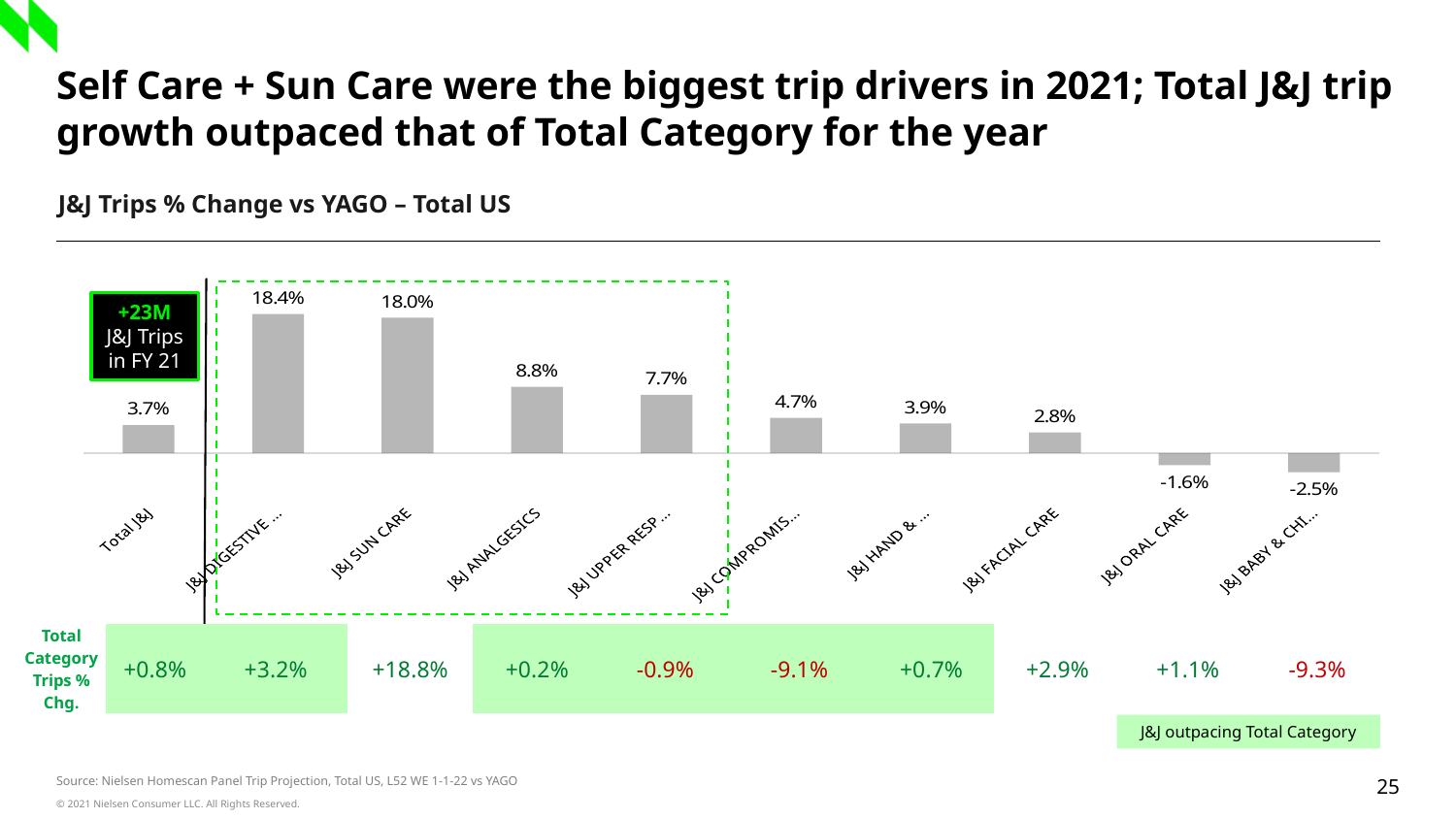
What is the J&J trips % change for J&J Oral Care? -1.6% What is the J&J trips % change for Total J&J? 3.7% What kind of chart is shown on the slide? Bar chart What is the title of the chart? J&J Trips % Change vs YAGO – Total US How many categories are plotted in the bar chart? 10 What is the J&J trips % change for J&J Sun Care? 18.0% Which has a larger J&J trips % change, Total J&J or J&J Facial Care? Total J&J What is the J&J trips % change for J&J Analgesics? 8.8% Which category has the lowest J&J trips % change? J&J Baby & Chi... What is the J&J trips % change for J&J Facial Care? 2.8% What is the difference between the J&J trips % change for J&J Sun Care and J&J Analgesics? 9.2 percentage points Which category has the highest J&J trips % change? J&J Digestive